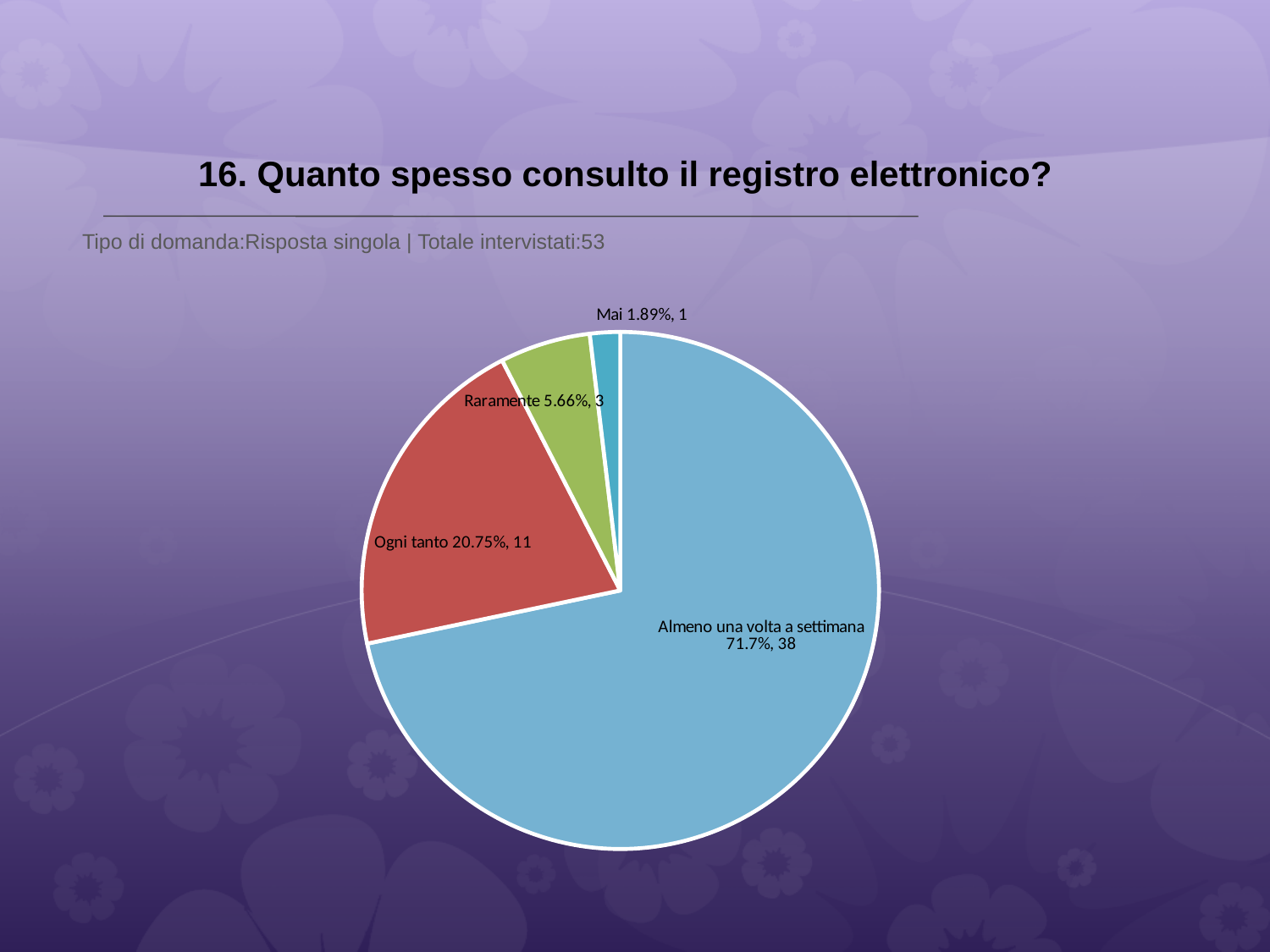
Which has more respondents, 'Raramente' or 'Ogni tanto'? Ogni tanto What is the title of the chart on the slide? 16. Quanto spesso consulto il registro elettronico? What kind of chart is shown on the slide? pie chart How many respondents answered 'Raramente'? 3 How many respondents answered 'Ogni tanto'? 11 Which category has the smallest slice of the pie? Mai What percentage share does the 'Mai' slice have? 1.89% How many slices does the pie chart have? 4 What is the total number of respondents shown across all slices? 53 What percentage share does the 'Almeno una volta a settimana' slice have? 71.7% What is the difference in respondent count between 'Almeno una volta a settimana' and 'Ogni tanto'? 27 Which category has the largest slice of the pie? Almeno una volta a settimana